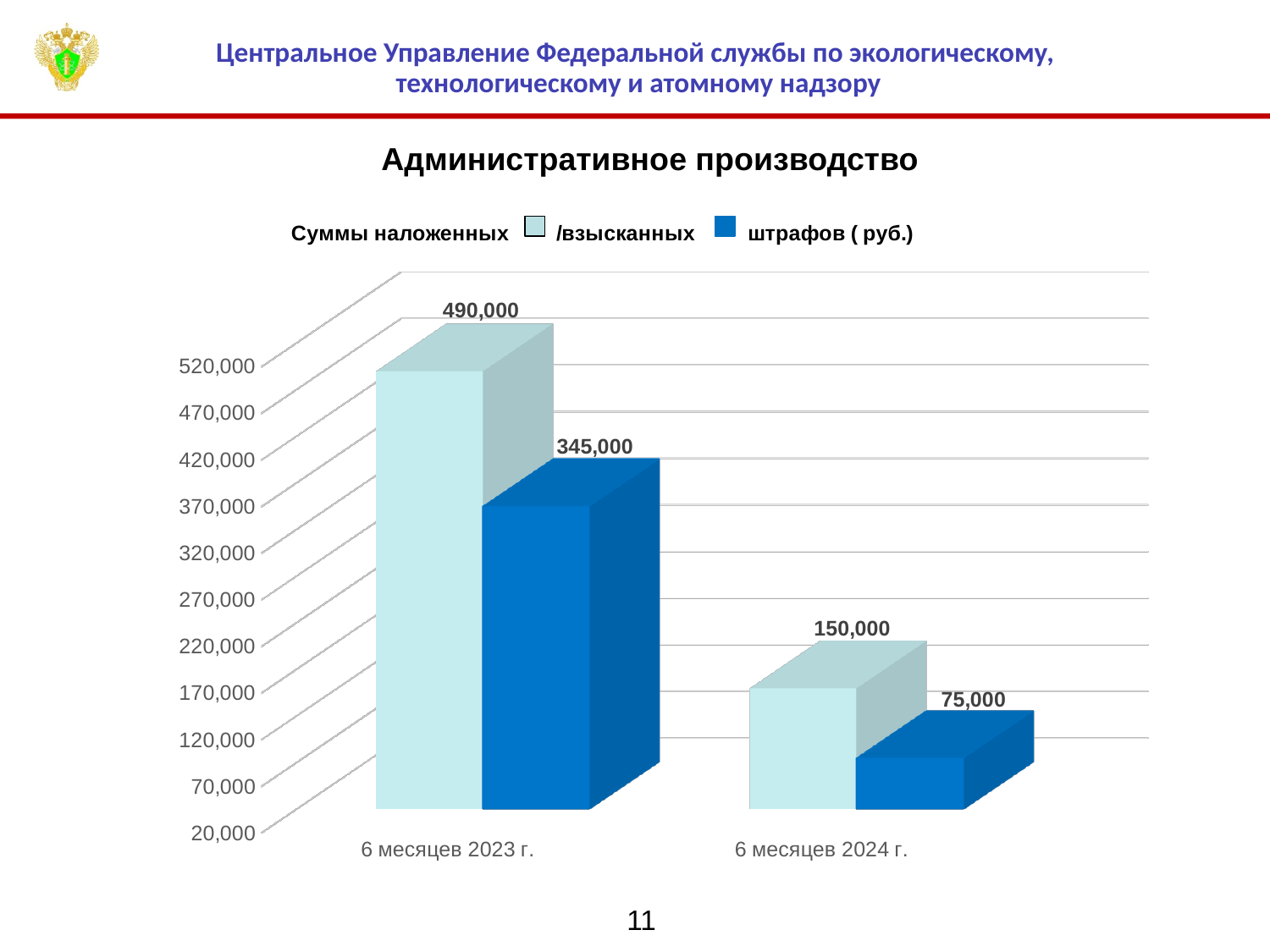
What is the difference between the imposed fines for 6 месяцев 2023 г. and 6 месяцев 2024 г.? 340,000 What kind of chart is shown on the slide? Bar chart How many periods (categories) are shown on the x axis? 2 What is the value of the collected fines (взысканных) for 6 месяцев 2023 г.? 345,000 How many series does the legend list? 2 Which period has the lowest value of collected fines (взысканных)? 6 месяцев 2024 г. What is the difference between imposed and collected fines for 6 месяцев 2023 г.? 145,000 What is the value of the imposed fines (наложенных) for 6 месяцев 2024 г.? 150,000 What is the value of the collected fines (взысканных) for 6 месяцев 2024 г.? 75,000 Which is larger: collected fines for 6 месяцев 2023 г. or imposed fines for 6 месяцев 2024 г.? Collected fines for 6 месяцев 2023 г. What is the value of the imposed fines (наложенных) for 6 месяцев 2023 г.? 490,000 Which period has the highest value of imposed fines (наложенных)? 6 месяцев 2023 г.